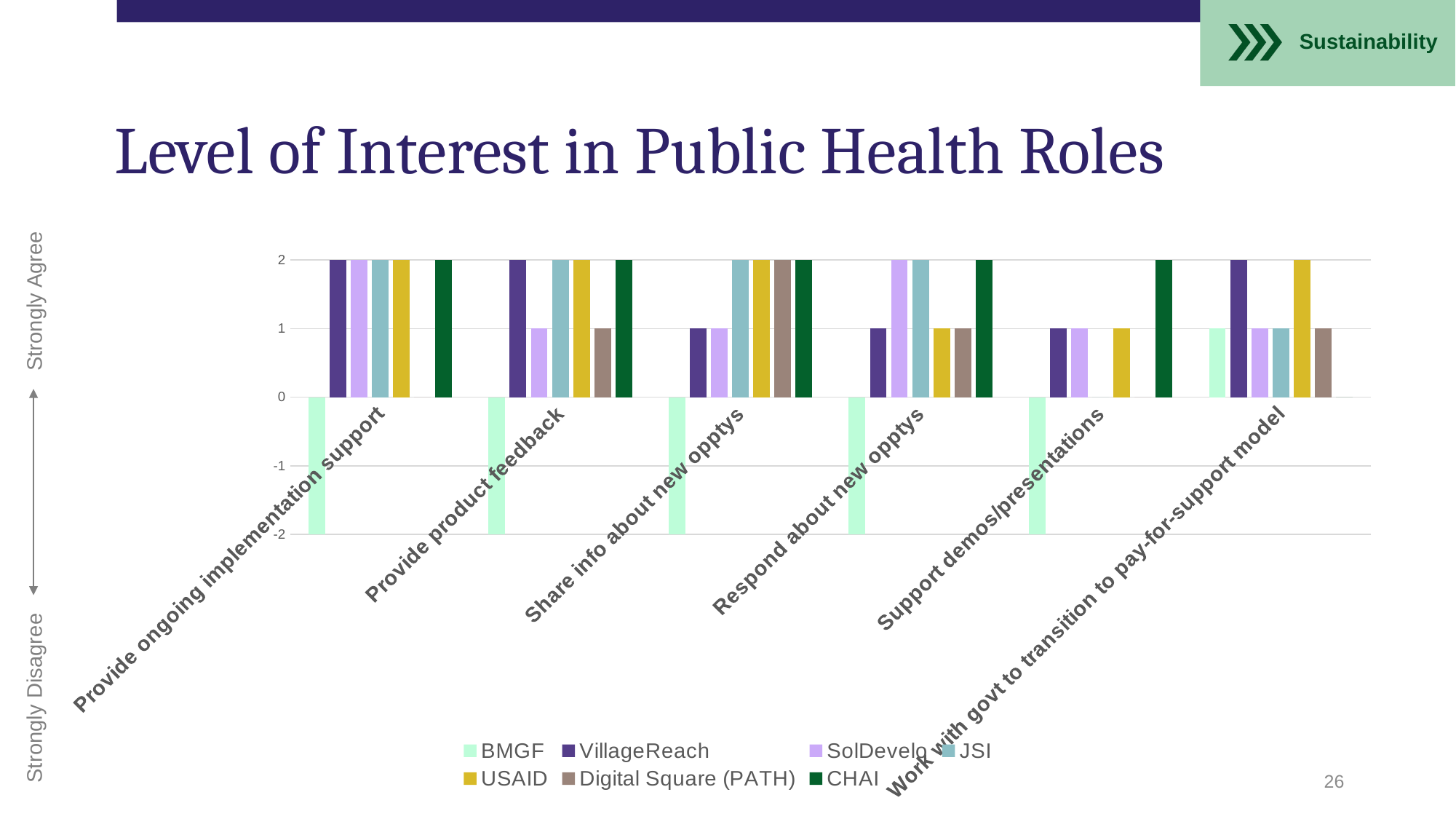
What is the difference between the USAID value and the BMGF value in the 'Provide ongoing implementation support' category? 4 What is the title of the chart? Level of Interest in Public Health Roles What is the value for BMGF in the 'Work with govt to transition to pay-for-support model' category? 1 How many series does the legend list? 7 How many categories are shown on the x axis? 6 What kind of chart is shown on the slide? Bar chart Is the value for BMGF in the 'Share info about new opptys' category greater or less than 0? less What is the value for VillageReach in the 'Share info about new opptys' category? 1 What is the value for BMGF in the 'Provide product feedback' category? -2 Which is larger in the 'Provide product feedback' category: the value for SolDevelo or the value for JSI? JSI Which series has the lowest value in the 'Respond about new opptys' category? BMGF What is the value for CHAI in the 'Support demos/presentations' category? 2